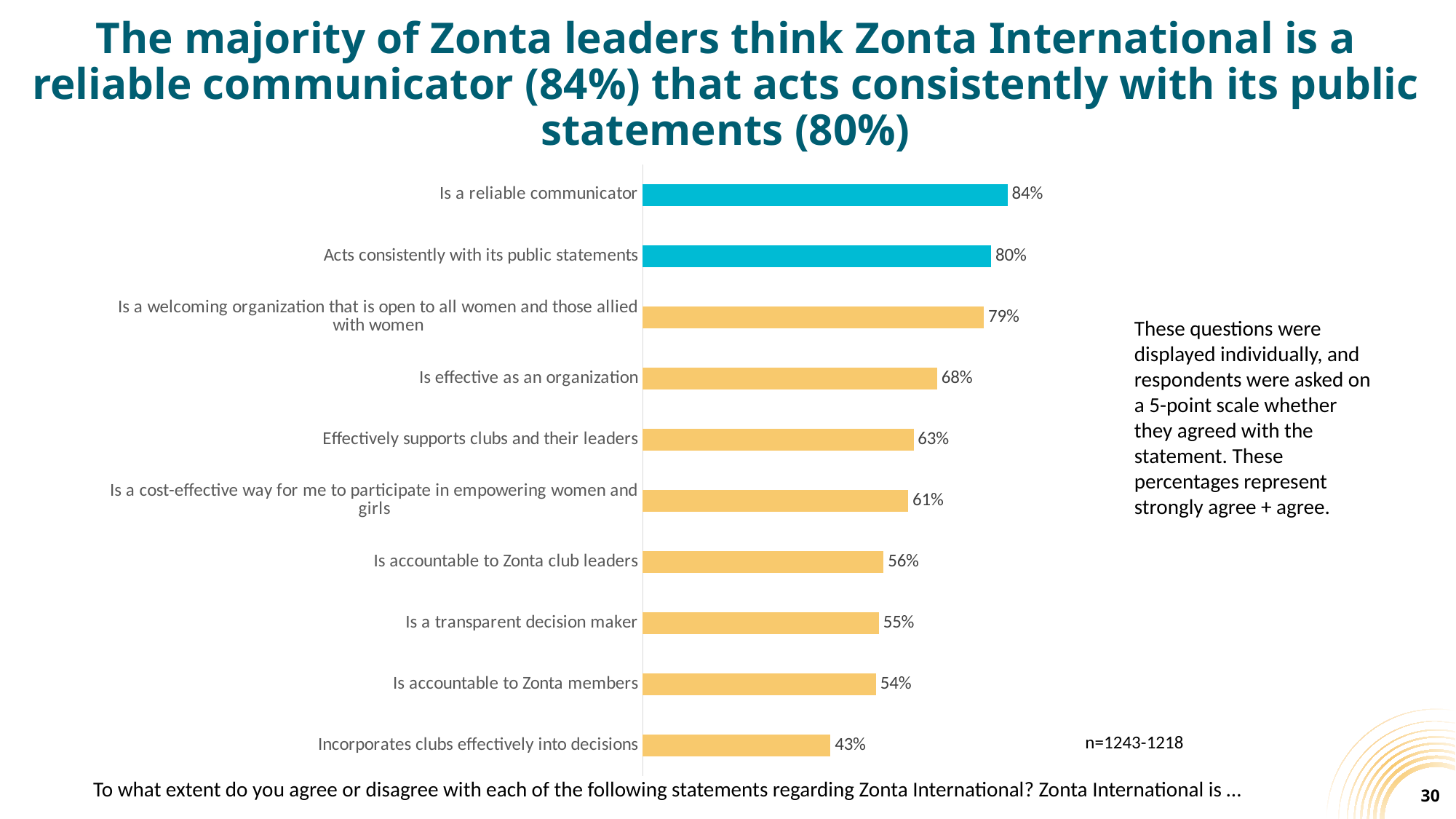
Which statement has the highest level of agreement? Is a reliable communicator How many bars are highlighted in blue rather than yellow? 2 What sample size is noted on the slide? n=1243-1218 How many statements are shown in the chart? 10 What is the value for 'Is effective as an organization'? 68% Which is larger: the value for 'Is a welcoming organization that is open to all women and those allied with women' or the value for 'Is accountable to Zonta club leaders'? Is a welcoming organization that is open to all women and those allied with women What is the value for 'Is accountable to Zonta members'? 54% Which statement has the lowest level of agreement? Incorporates clubs effectively into decisions What kind of chart is shown on the slide? Bar chart What is the difference between 'Effectively supports clubs and their leaders' and 'Is a cost-effective way for me to participate in empowering women and girls'? 2 percentage points What percentage of Zonta leaders agree that Zonta International is a reliable communicator? 84% What is the difference between 'Is a reliable communicator' and 'Incorporates clubs effectively into decisions'? 41 percentage points